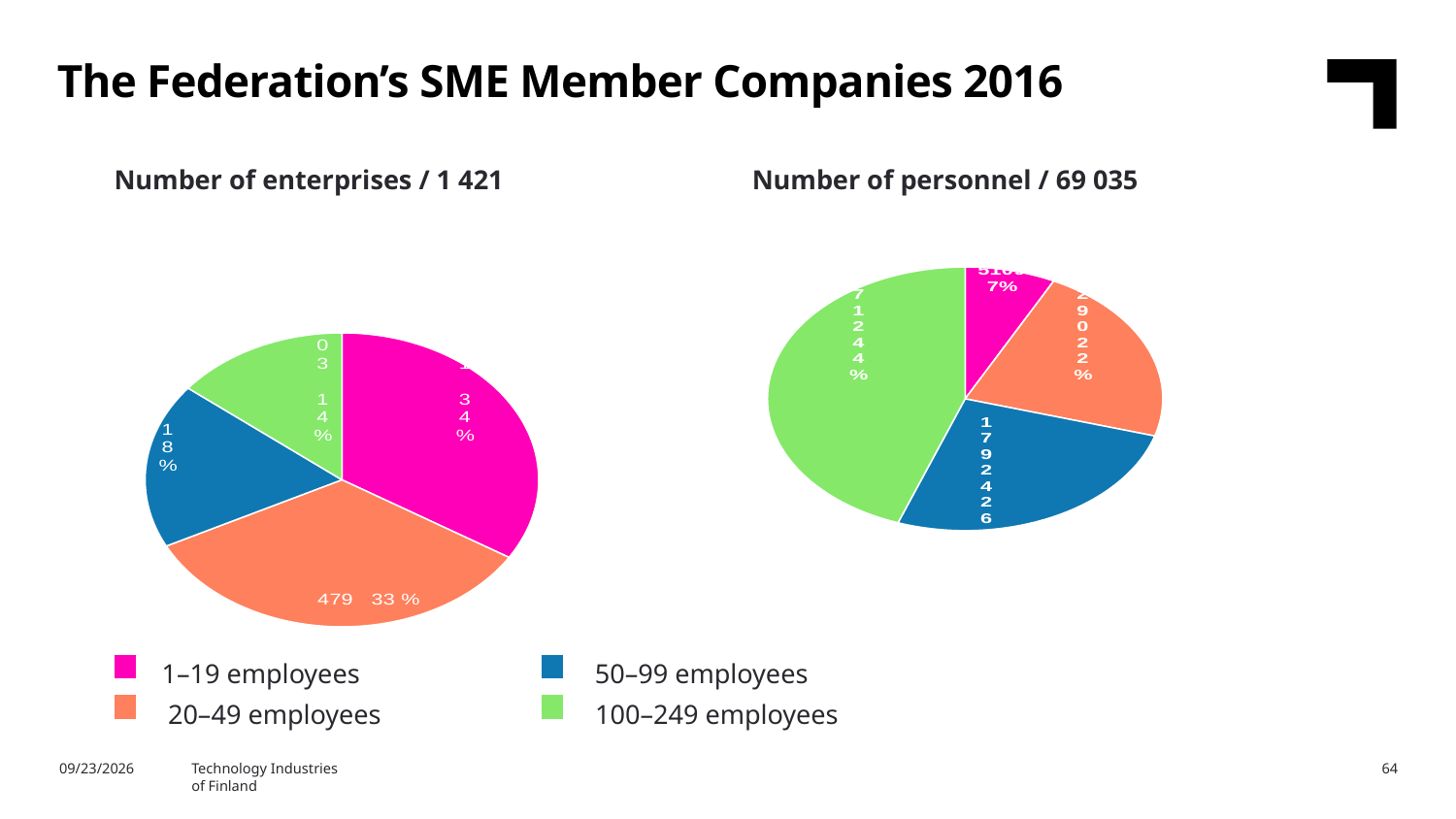
In the 'Number of enterprises / 1 421' chart, which category has the smallest slice? 100–249 employees In the 'Number of enterprises / 1 421' chart, how many enterprises are in the 20–49 employees category? 479 In the 'Number of enterprises / 1 421' chart, what share of the pie is the 100–249 employees slice? 14% In the 'Number of enterprises / 1 421' chart, what is the difference in percentage points between the 1–19 employees slice and the 100–249 employees slice? 20 percentage points In the 'Number of personnel / 69 035' chart, what share of the pie is the 1–19 employees slice? 7% In the 'Number of enterprises / 1 421' chart, what share of the pie is the 20–49 employees slice? 33 % How many employee-size categories does the legend list? 4 What kind of chart is used on this slide? Pie chart What is the title of the chart on the right side of the slide? Number of personnel / 69 035 In the 'Number of enterprises / 1 421' chart, which slice is larger: 50–99 employees or 100–249 employees? 50–99 employees In the 'Number of personnel / 69 035' chart, which category has the largest slice? 100–249 employees